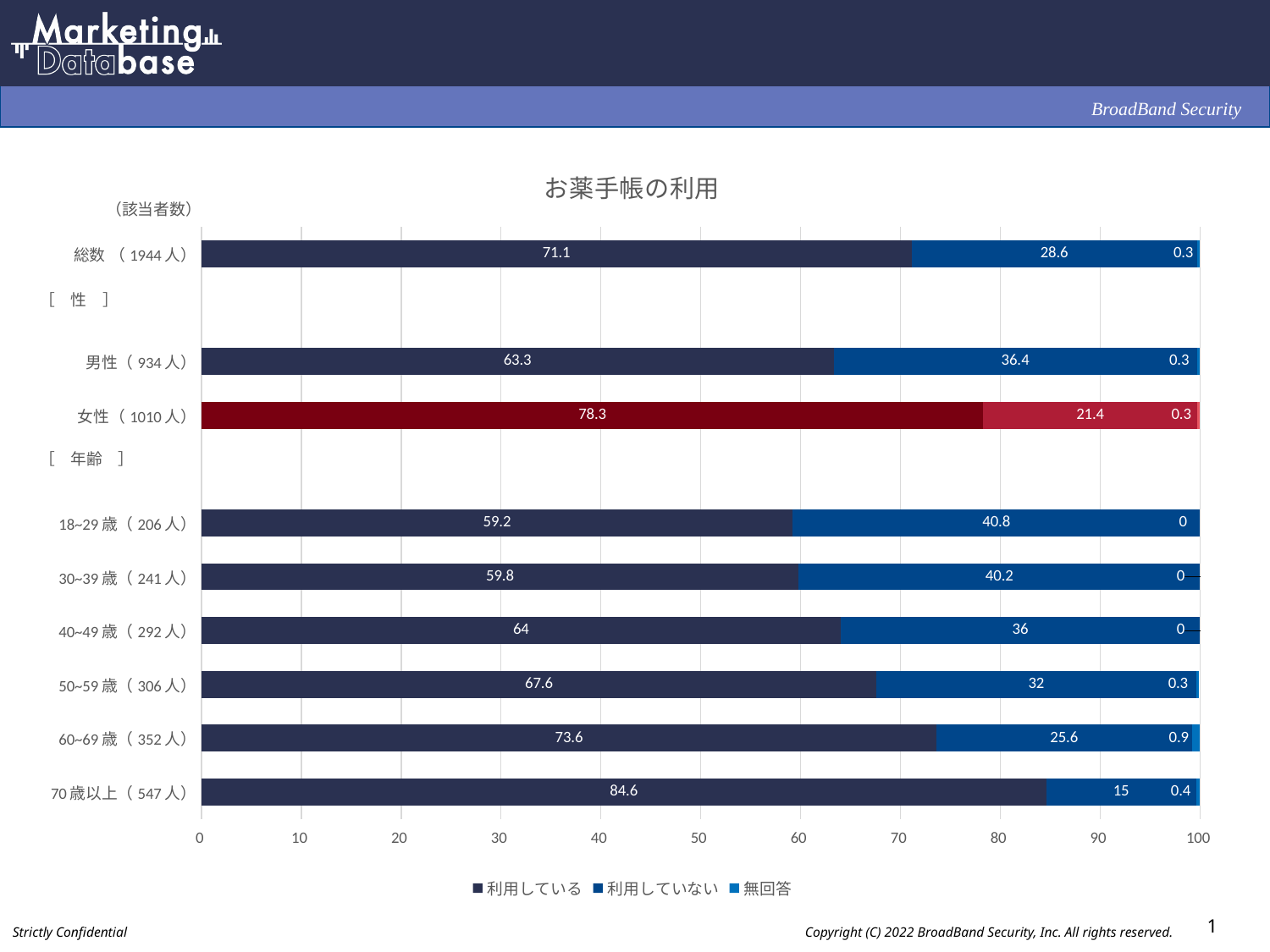
What is the 利用していない value for 男性 (934人)? 36.4 Which is larger, the 利用していない value for 18~29歳 (206人) or for 70歳以上 (547人)? 18~29歳 (206人) Across the age groups from 18~29歳 to 70歳以上, does the 利用している value rise or fall with age? Rise How many series does the legend list? 3 What is the 利用している value for 総数 (1944人)? 71.1 Which category has the highest 利用している value? 70歳以上 (547人) Which category has the lowest 利用している value? 18~29歳 (206人) What is the 利用している value for 女性 (1010人)? 78.3 What is the 無回答 value for 60~69歳 (352人)? 0.9 What type of chart is shown on the slide? Stacked bar chart What is the title of the chart? お薬手帳の利用 What is the difference between the 利用している values for 女性 (1010人) and 男性 (934人)? 15